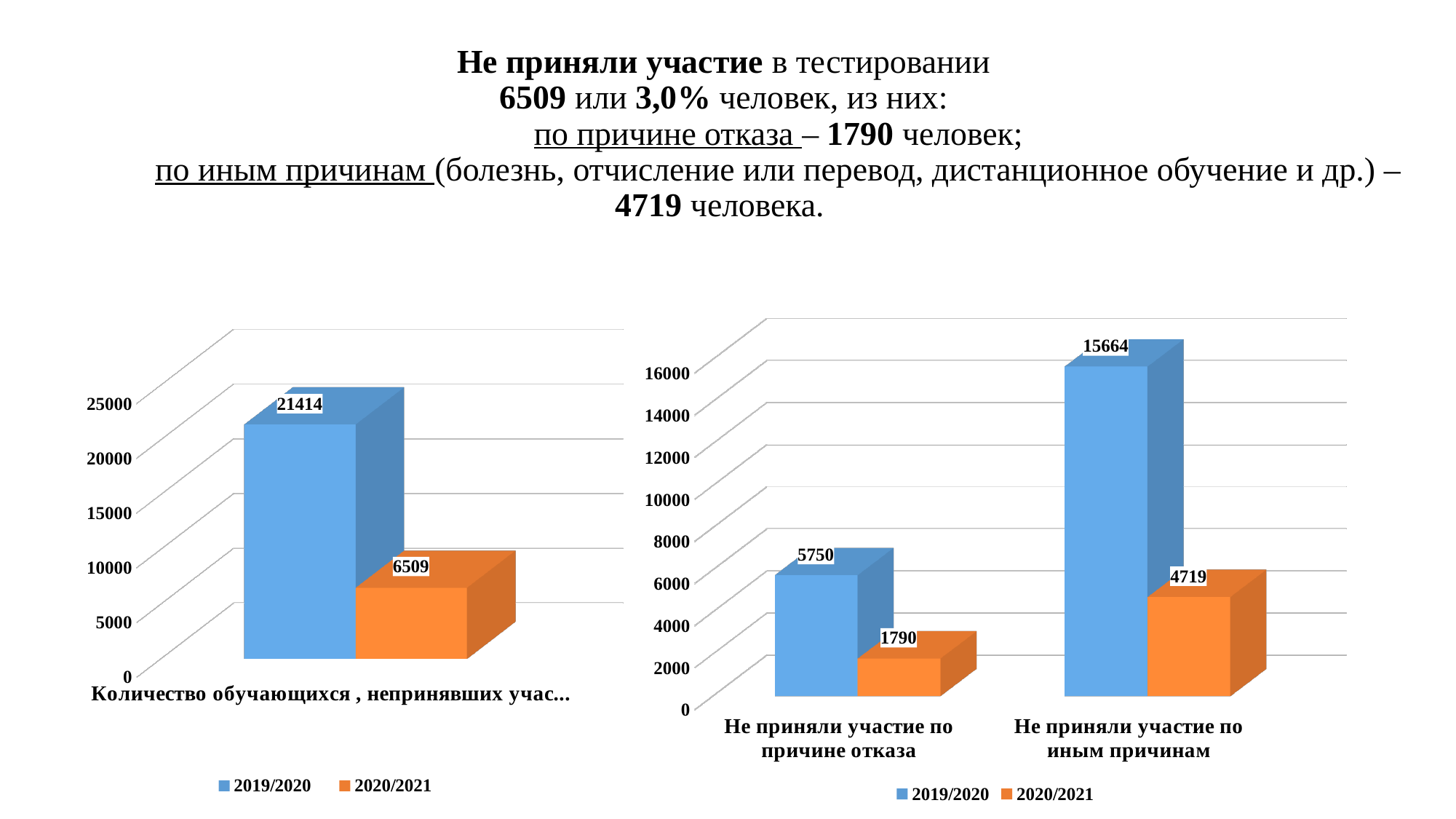
In the right chart, what is the difference between the 2019/2020 and 2020/2021 values for 'Не приняли участие по иным причинам'? 10945 In the left chart, what is the value for the 2019/2020 series? 21414 In the right chart, how many categories are shown on the x axis? 2 In the right chart, what is the 2019/2020 value for 'Не приняли участие по причине отказа'? 5750 In the right chart, what is the 2020/2021 value for 'Не приняли участие по иным причинам'? 4719 In the left chart, how many series does the legend list? 2 What kind of chart is the right chart? Bar chart In the left chart, what is the difference between the 2019/2020 and 2020/2021 values? 14905 In the right chart, what is the 2020/2021 value for 'Не приняли участие по причине отказа'? 1790 In the right chart, which category has the highest 2019/2020 value? Не приняли участие по иным причинам In the right chart, which is larger: the 2020/2021 value for 'Не приняли участие по иным причинам' or the 2019/2020 value for 'Не приняли участие по причине отказа'? 2019/2020 value for 'Не приняли участие по причине отказа' In the left chart, what is the value for the 2020/2021 series? 6509